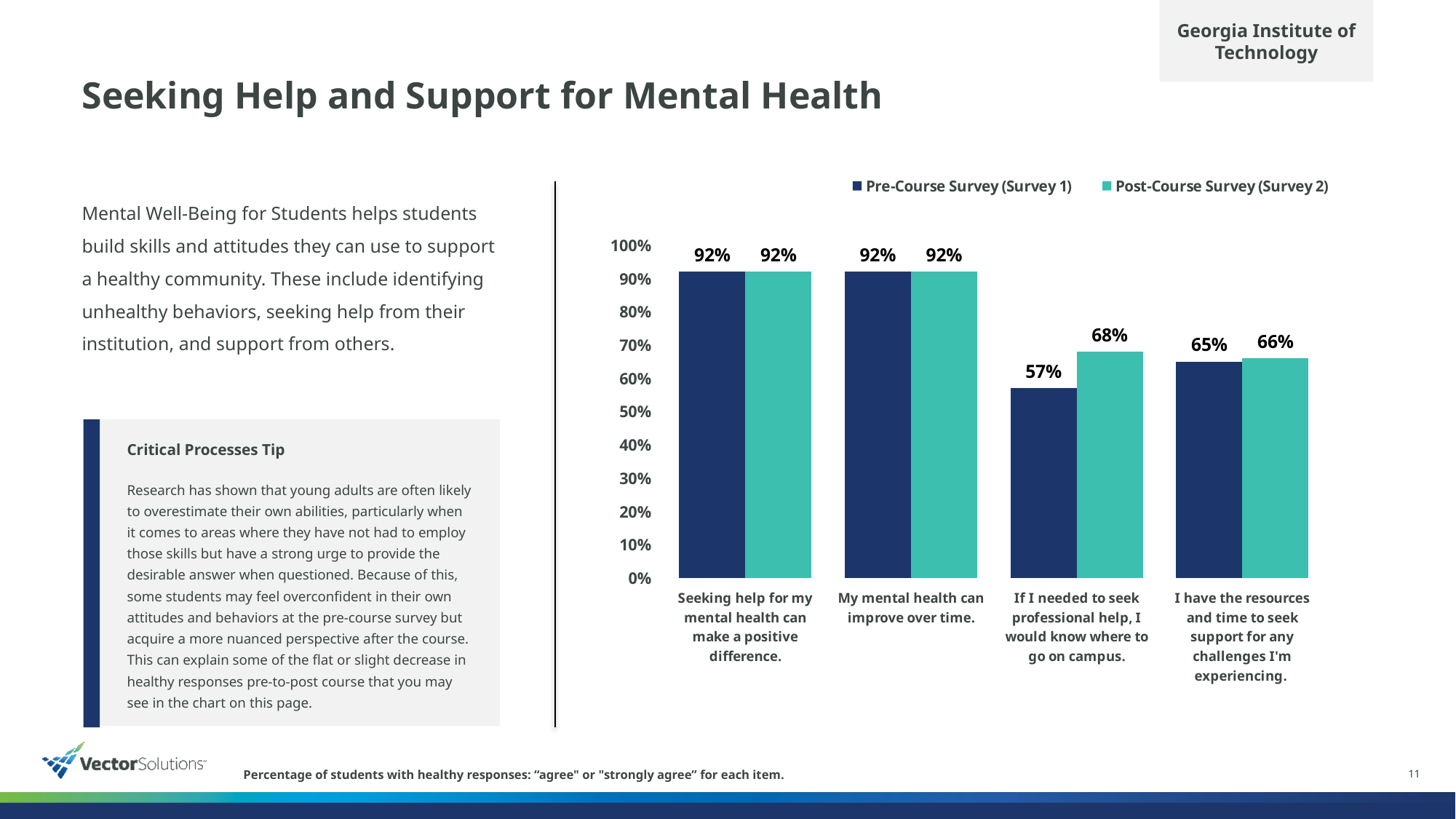
Which category has the lowest Pre-Course Survey (Survey 1) value? If I needed to seek professional help, I would know where to go on campus. How many series does the chart legend list? 2 What are the two series named in the chart legend? Pre-Course Survey (Survey 1) and Post-Course Survey (Survey 2) What is the Post-Course Survey (Survey 2) value for "I have the resources and time to seek support for any challenges I'm experiencing."? 66% What is the difference between the Post-Course and Pre-Course Survey values for "If I needed to seek professional help, I would know where to go on campus."? 11% Is the Pre-Course Survey (Survey 1) value for "I have the resources and time to seek support for any challenges I'm experiencing." greater or less than 60%? greater What kind of chart is shown on the slide? Bar chart What is the Pre-Course Survey (Survey 1) value for "If I needed to seek professional help, I would know where to go on campus."? 57% Which is larger for "If I needed to seek professional help, I would know where to go on campus.": the Pre-Course Survey value or the Post-Course Survey value? Post-Course Survey (Survey 2) What is the Post-Course Survey (Survey 2) value for "My mental health can improve over time."? 92% What is the difference between the Post-Course and Pre-Course Survey values for "I have the resources and time to seek support for any challenges I'm experiencing."? 1% How many categories are shown on the x axis of the chart? 4